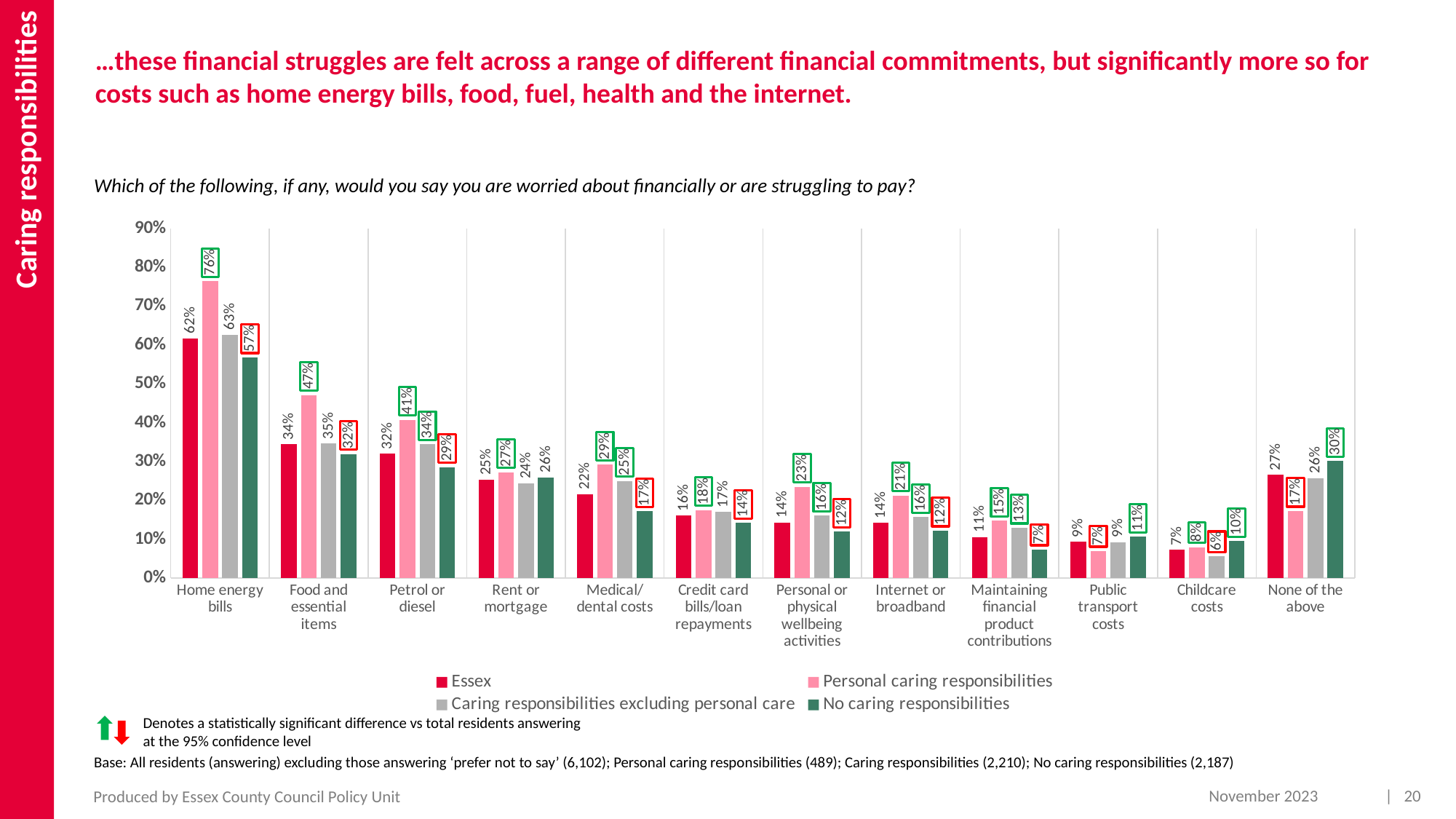
What kind of chart is shown on the slide? Bar chart How many categories are shown on the x axis of the chart? 12 What is the difference between the Personal caring responsibilities value and the No caring responsibilities value for Petrol or diesel? 12 percentage points What is the Essex value for Food and essential items? 34% Which category has the lowest value for the No caring responsibilities series? Maintaining financial product contributions What percentage of residents with personal caring responsibilities are worried about home energy bills? 76% Which category has the highest value for the Personal caring responsibilities series? Home energy bills Is the Personal caring responsibilities value for Food and essential items greater or less than 40%? greater What percentage of residents with no caring responsibilities selected None of the above? 30% What is the Caring responsibilities excluding personal care value for Medical/dental costs? 25% For Childcare costs, which is larger: the Essex value or the No caring responsibilities value? No caring responsibilities How many series does the legend list? 4